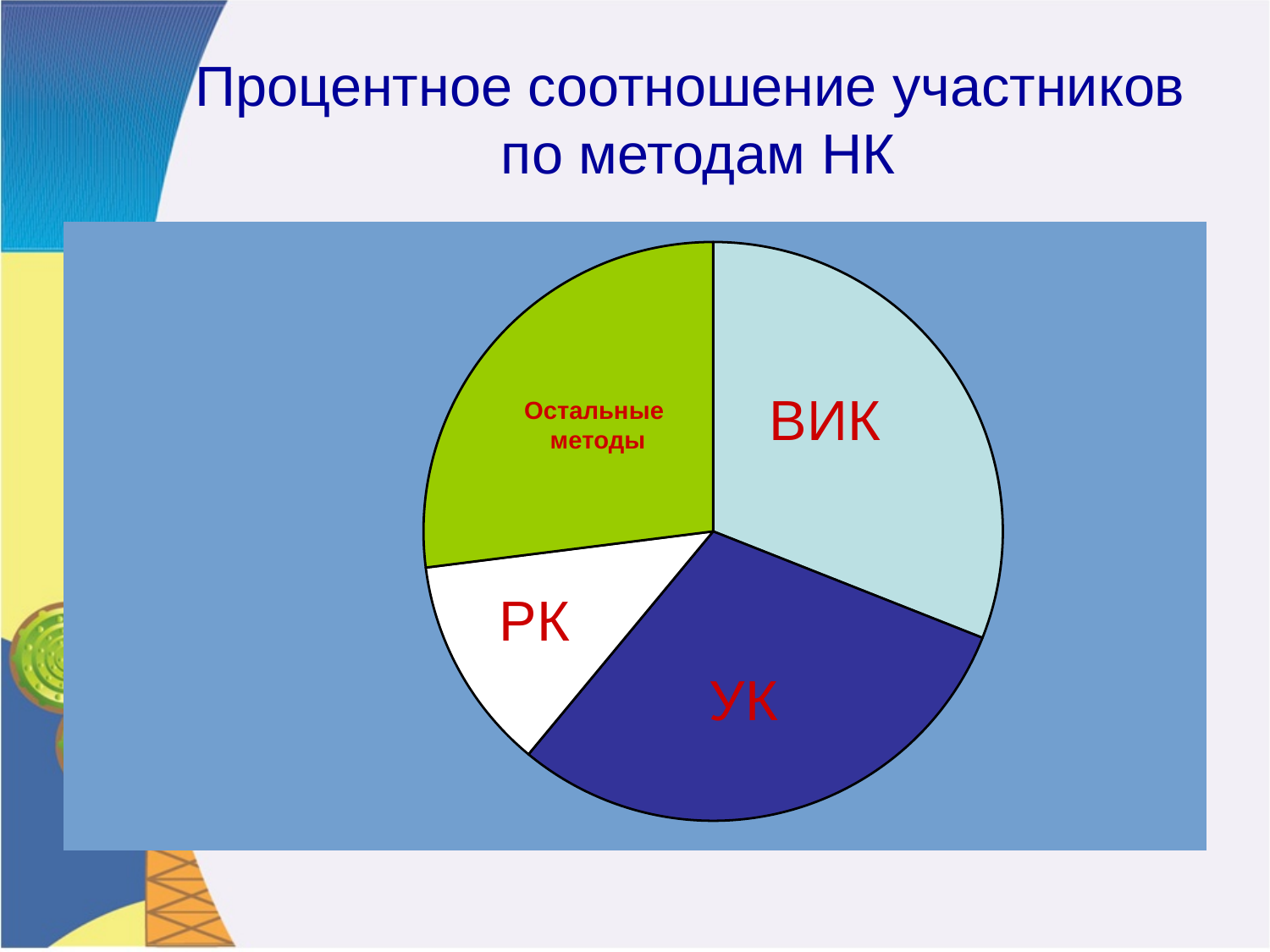
What colour is the slice labelled Остальные методы? green How many slices does the pie chart have? 4 Which slice is larger, ВИК or РК? ВИК Which slice is larger, Остальные методы or РК? Остальные методы What kind of chart is shown on the slide? pie chart What is the title of the slide containing the pie chart? Процентное соотношение участников по методам НК Which slice of the pie chart is the smallest? РК Which slice is larger, УК or РК? УК